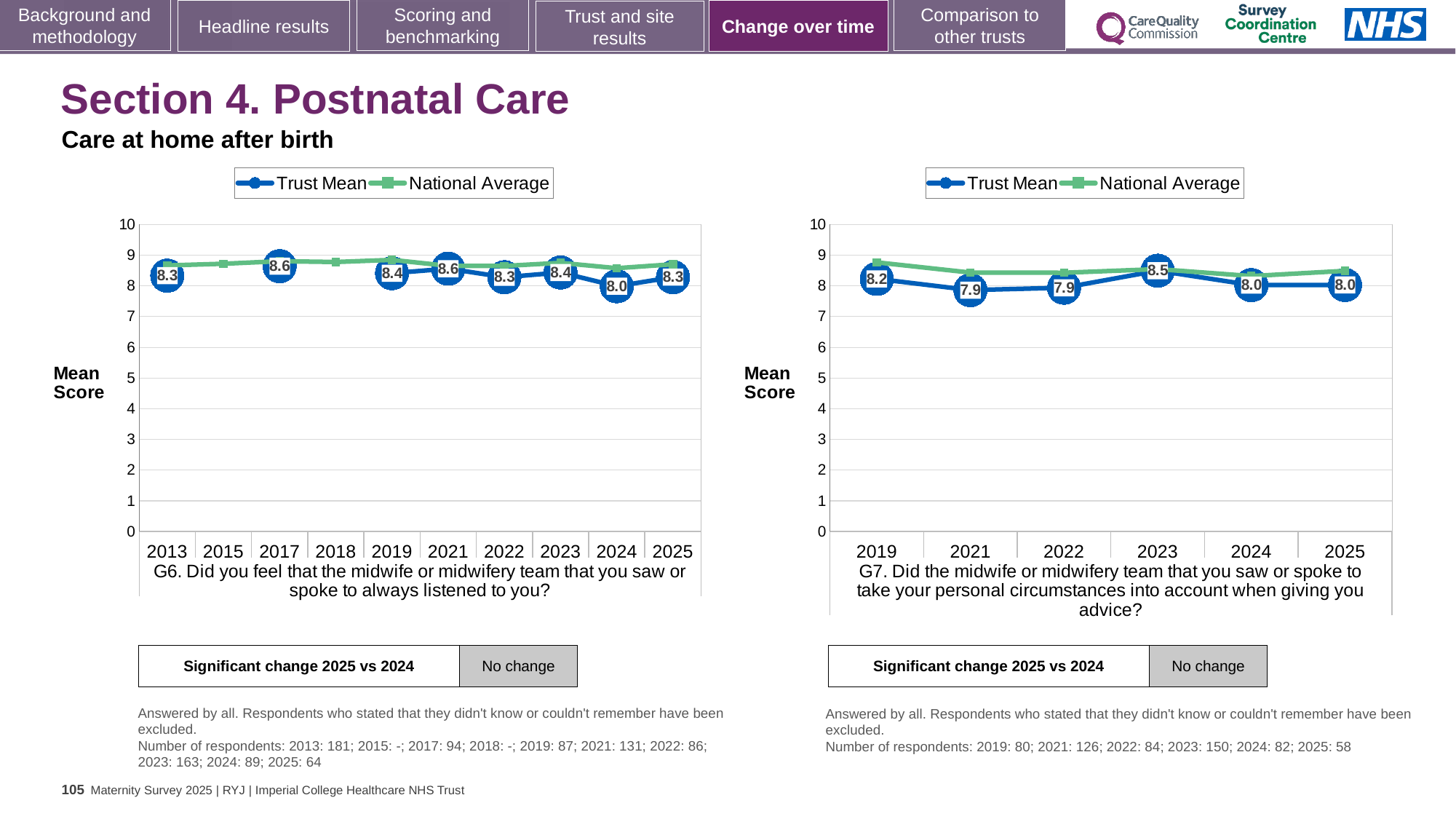
How many years are shown on the x axis of the right chart (G7)? 6 In the right chart (G7), what is the Trust Mean score for 2021? 7.9 What kind of chart is the left chart (G6)? Line chart In the right chart (G7), what is the Trust Mean score for 2023? 8.5 In the left chart (G6), which year has the lowest Trust Mean score? 2024 How many series does the legend of the left chart (G6) list? 2 In the right chart (G7), is the National Average value for 2019 greater or less than 8? greater In the left chart (G6), what is the difference between the Trust Mean scores for 2021 and 2024? 0.6 In the right chart (G7), which year has the larger Trust Mean score, 2019 or 2021? 2019 In the right chart (G7), which year has the highest Trust Mean score? 2023 In the left chart (G6), what is the Trust Mean score for 2017? 8.6 In the left chart (G6), what is the Trust Mean score for 2024? 8.0